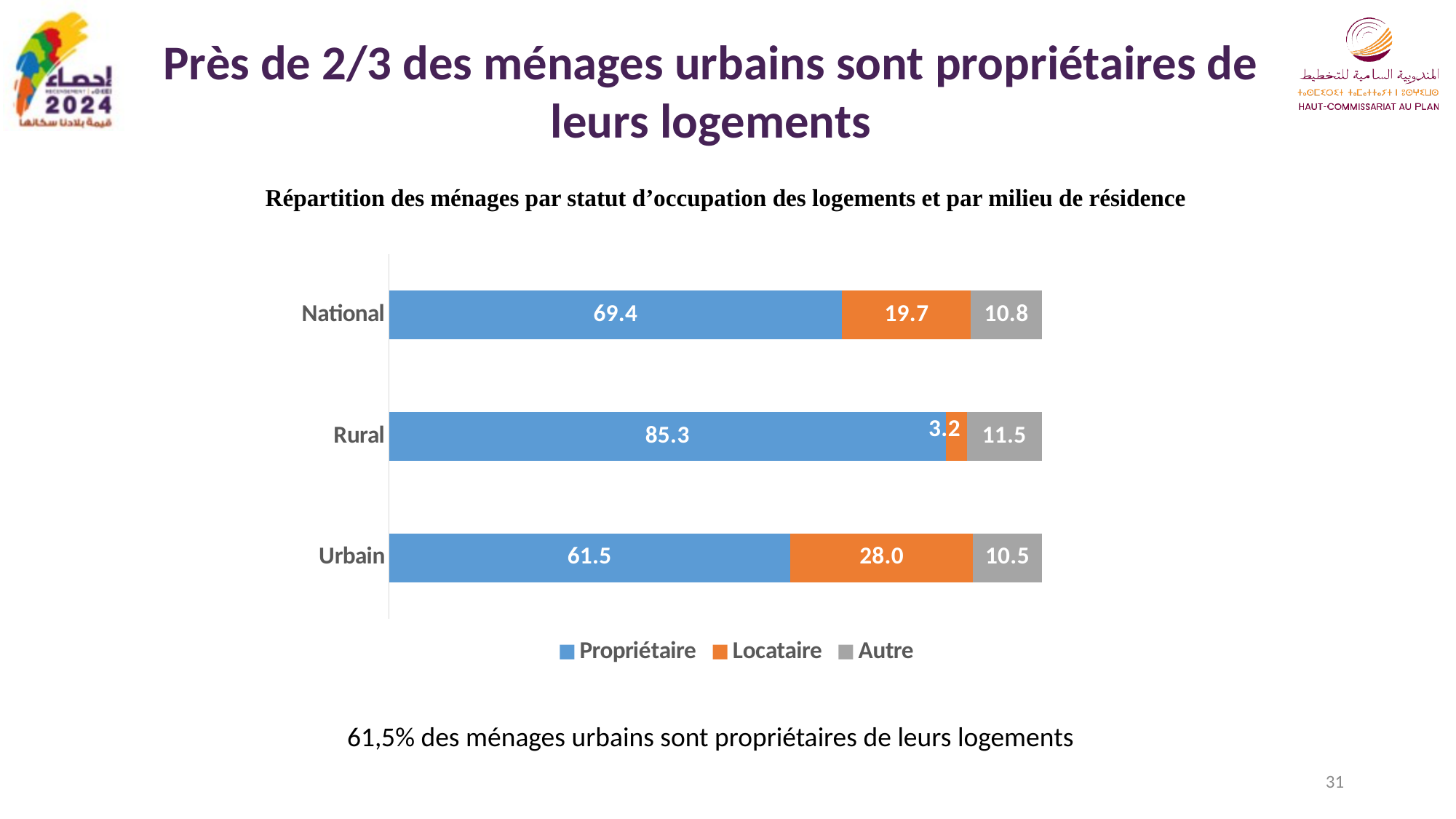
Which category has the lowest Locataire value? Rural Which series is shown in orange in the legend? Locataire What is the difference between the Propriétaire values for Rural and Urbain? 23.8 Which category has the highest Propriétaire value? Rural What is the Propriétaire value for Rural? 85.3 What is the Autre value for National? 10.8 What is the Locataire value for Urbain? 28.0 How many categories are shown on the y axis? 3 What kind of chart is shown? Stacked bar chart Which is larger, the Locataire value for National or for Urbain? Urbain What is the total of the stacked bar for Rural? 100.0 How many series does the legend list? 3